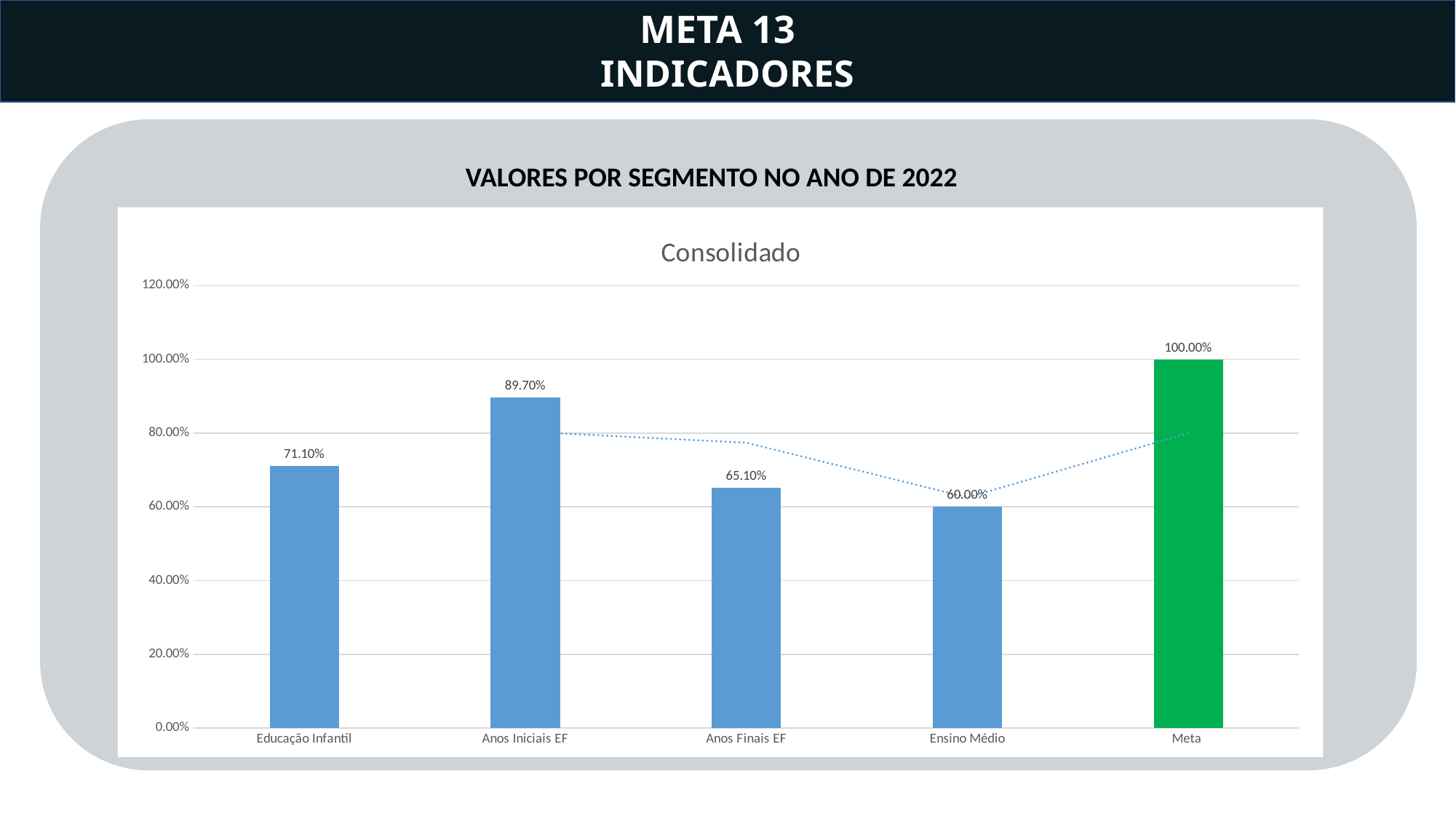
What is the value for Educação Infantil? 71.10% Which category has the lowest value? Ensino Médio Which is larger, the value for Educação Infantil or the value for Anos Finais EF? Educação Infantil What is the difference between the values for Anos Iniciais EF and Anos Finais EF? 24.60% Is the value for Anos Finais EF greater or less than 80.00%? less What is the title of the chart? Consolidado What is the value for Meta? 100.00% What is the value for Anos Iniciais EF? 89.70% How many categories are shown on the x axis? 5 What kind of chart is this? bar chart What is the value for Ensino Médio? 60.00% Which category has the highest value? Meta